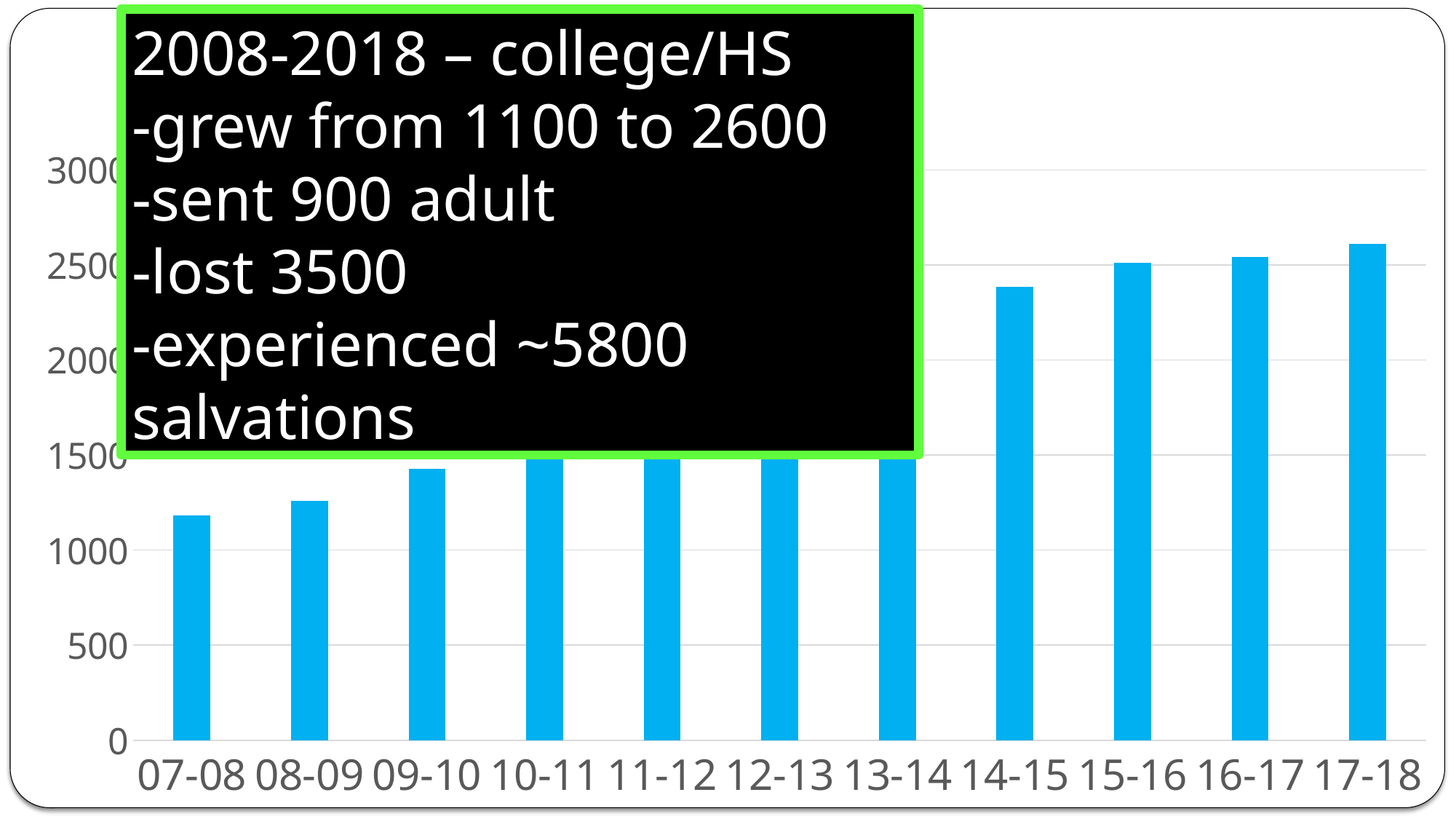
How many year categories are shown on the x axis? 11 Is the value for 07-08 greater or less than 1500? less Is the value for 09-10 greater or less than 1000? greater Which is larger, the value for 08-09 or the value for 09-10? 09-10 Is the value for 17-18 greater or less than 2500? greater Which year category has the lowest bar? 07-08 Do the bar values generally rise or fall from 07-08 to 17-18? rise Which is larger, the value for 07-08 or the value for 17-18? 17-18 What kind of chart is shown on the slide? bar chart What is the highest value labelled on the vertical axis? 3000